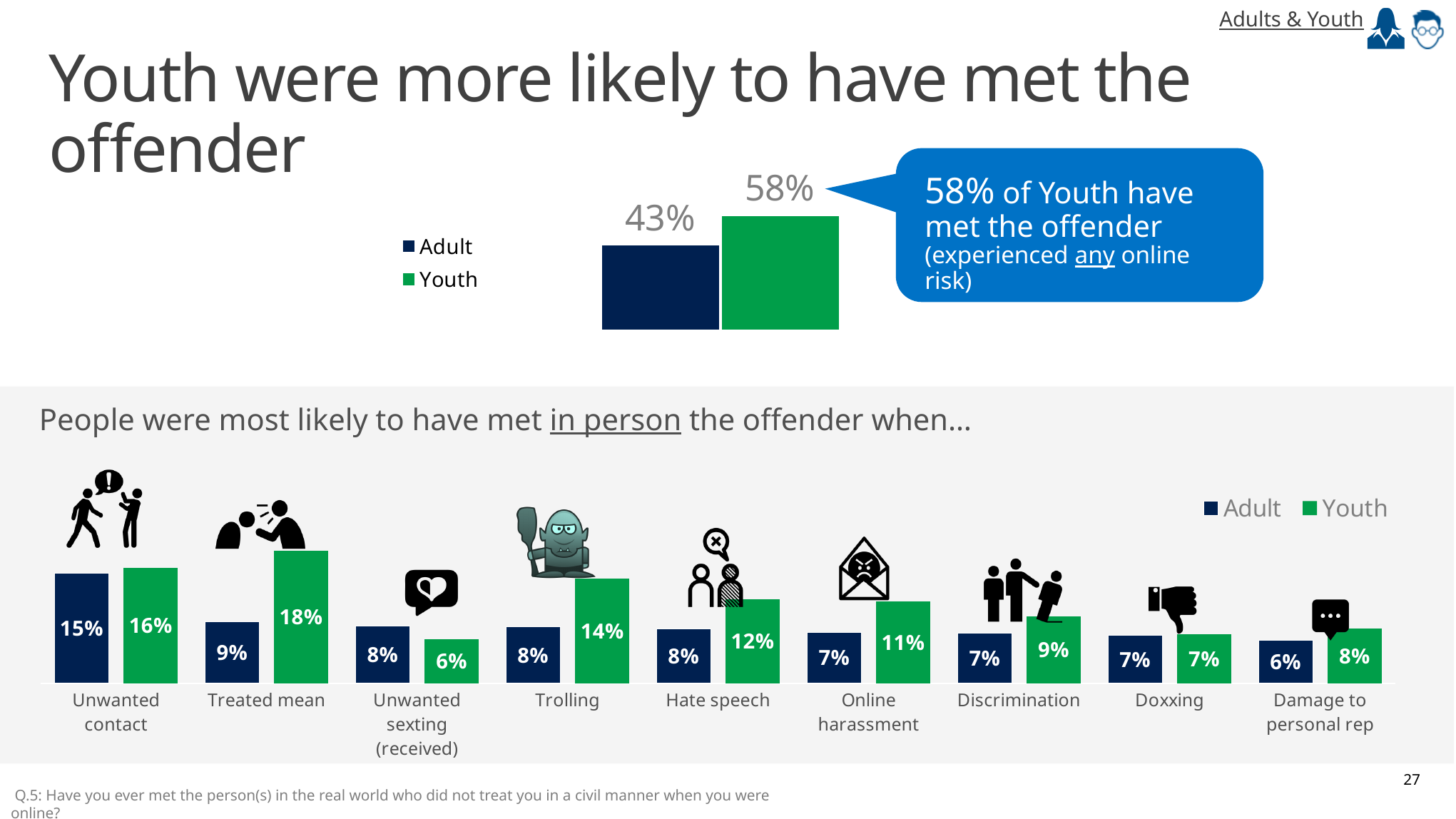
In the bottom chart, which category has the highest Youth value? Treated mean How many series does the legend of the bottom chart list? 2 In the bottom chart, which category has the lowest Adult value? Damage to personal rep In the bottom chart, what is the difference between the Youth and Adult values for Trolling? 6% In the bottom chart, which is larger for Unwanted sexting (received): the Adult value or the Youth value? Adult In the bottom chart, what is the Youth value for Treated mean? 18% In the bottom chart, what is the Adult value for Unwanted contact? 15% How many categories are shown in the bottom chart? 9 In the top chart, what is the value for Youth? 58% In the top chart, what is the difference between the Youth and Adult values? 15% In the top chart, what is the value for Adult? 43% What kind of chart is the bottom chart? Bar chart